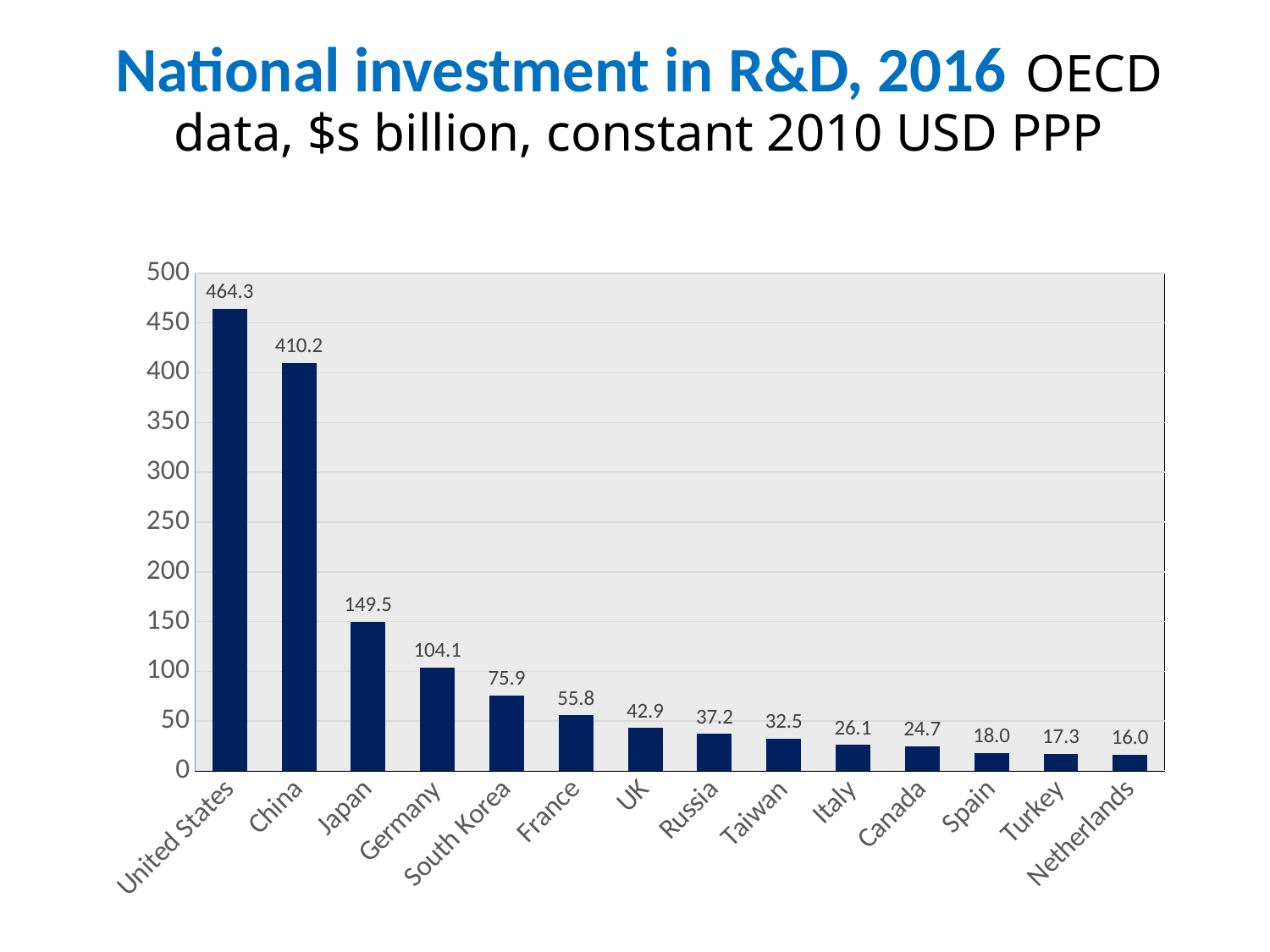
Which country has the lowest value? Netherlands What is the value for South Korea? 75.9 What is the difference between the values for Germany and France? 48.3 What kind of chart is shown on the slide? Bar chart Which country has the highest value? United States Do the values rise or fall from left to right along the x axis? Fall What is the value for the UK? 42.9 What is the value for Japan? 149.5 How many countries are shown in the chart? 14 Which is larger, the value for Russia or the value for Taiwan? Russia What is the difference between the values for the United States and China? 54.1 Is the value for China greater or less than 400? greater